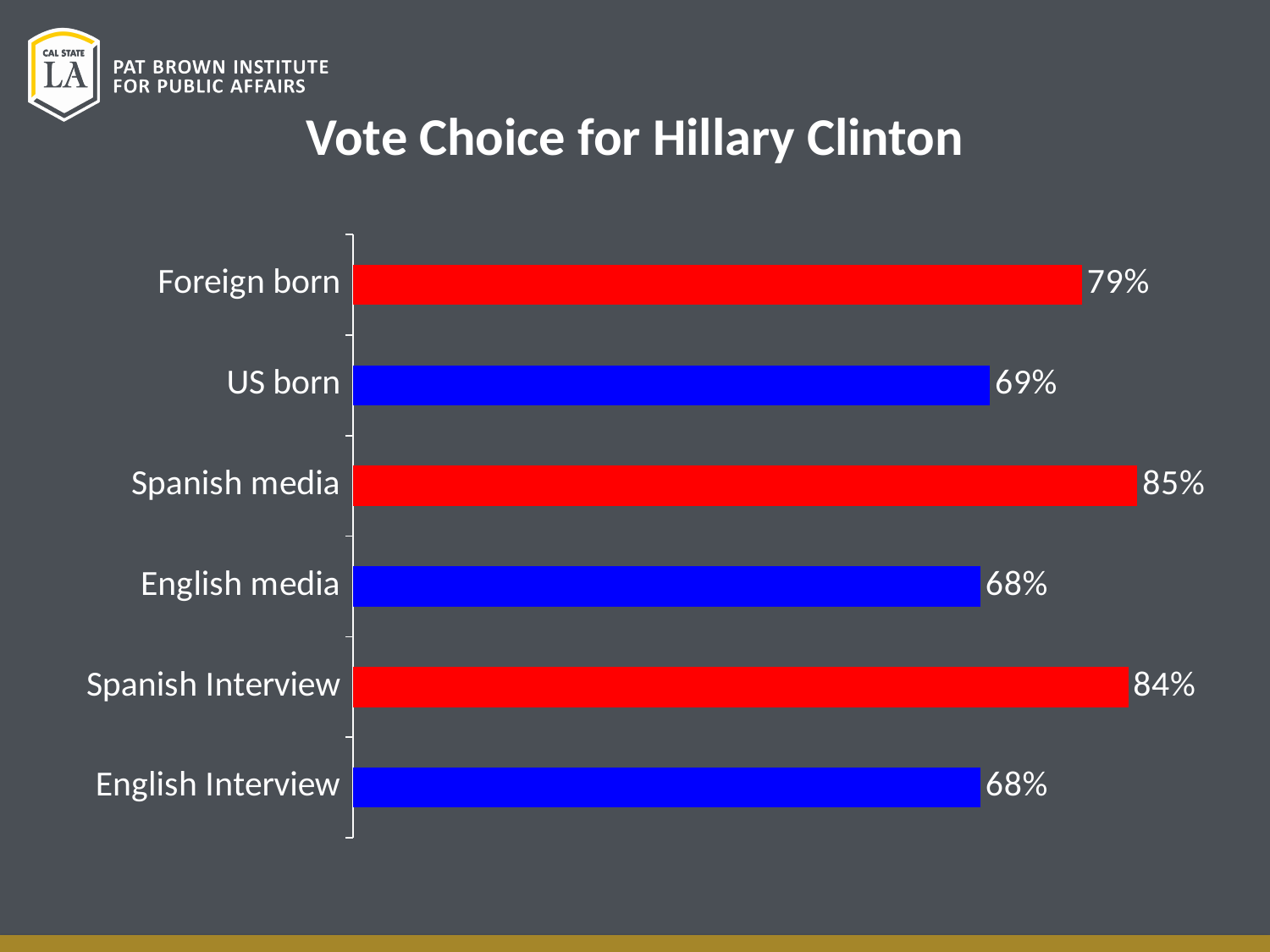
Which category has the highest value? Spanish media What is the value for Spanish media? 85% Which is larger, the value for Spanish media or the value for English media? Spanish media What is the value for Foreign born? 79% What is the difference between the values for Foreign born and US born? 10% Which is larger, the value for Foreign born or the value for Spanish Interview? Spanish Interview What is the value for US born? 69% What is the difference between the values for Spanish Interview and English Interview? 16% What is the title of the chart? Vote Choice for Hillary Clinton What kind of chart is shown on the slide? Bar chart How many categories are shown in the chart? 6 What is the value for English Interview? 68%